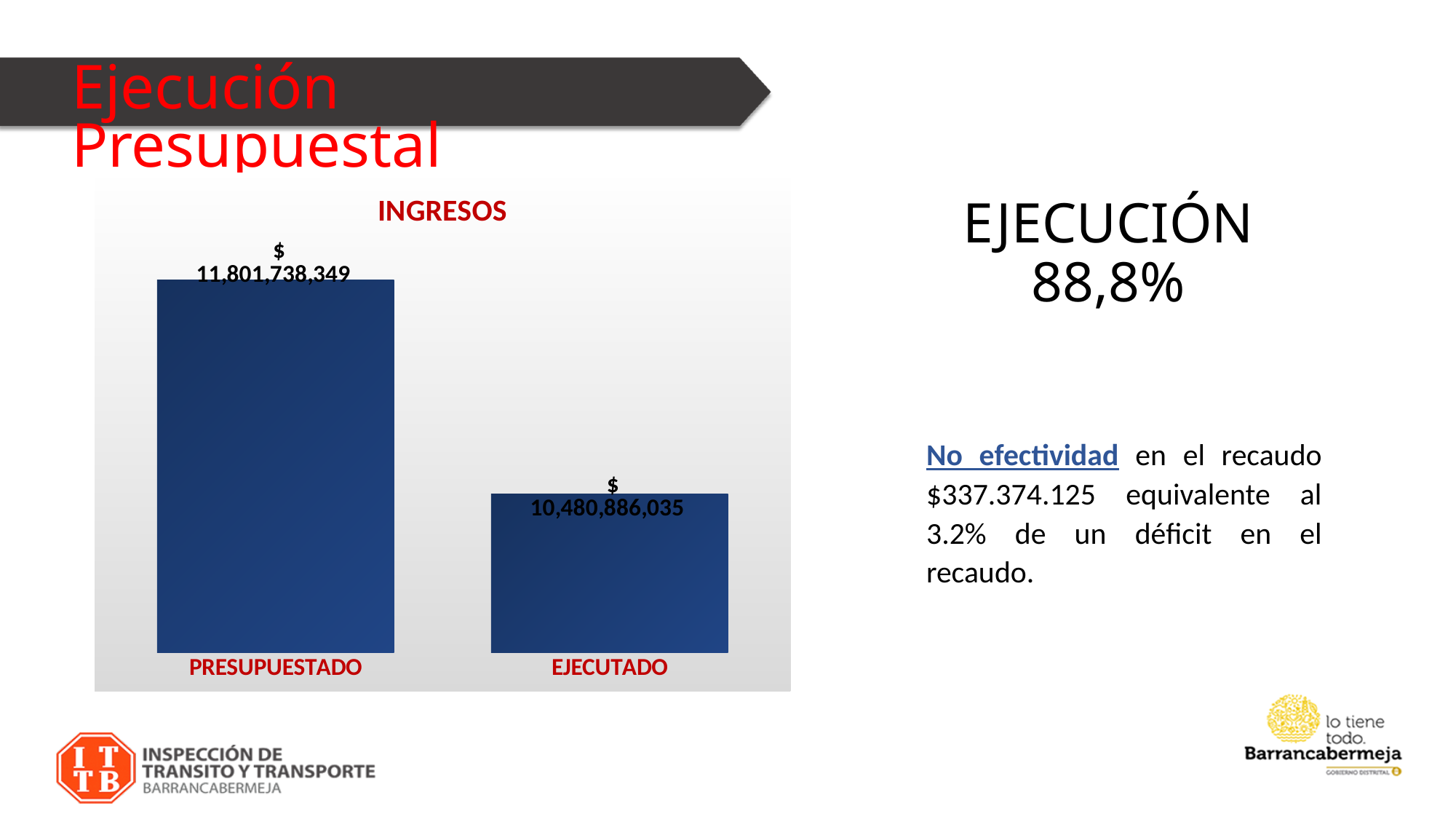
How many bars are shown in the INGRESOS chart? 2 What is the difference between the PRESUPUESTADO and EJECUTADO values in the INGRESOS chart? $ 1,320,852,314 Do the values fall or rise from PRESUPUESTADO to EJECUTADO in the INGRESOS chart? Fall Which category has the highest value in the INGRESOS chart? PRESUPUESTADO Which category has the lowest value in the INGRESOS chart? EJECUTADO Which is larger in the INGRESOS chart, PRESUPUESTADO or EJECUTADO? PRESUPUESTADO What kind of chart is shown on the slide? Bar chart What is the title of the chart on the slide? INGRESOS What colour are the bars in the INGRESOS chart? Blue What is the value for PRESUPUESTADO in the INGRESOS chart? $ 11,801,738,349 What is the value for EJECUTADO in the INGRESOS chart? $ 10,480,886,035